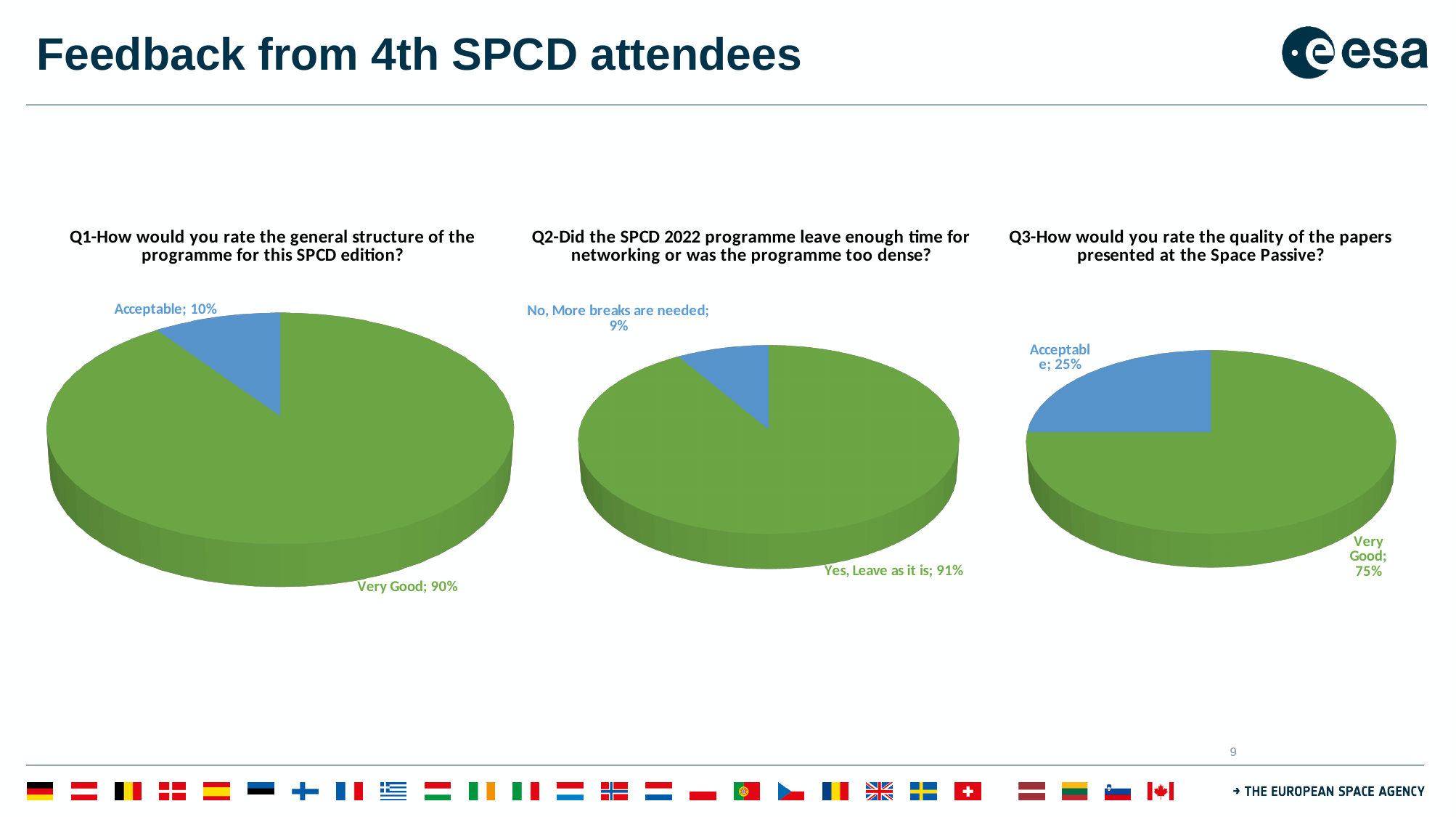
In the Q3 chart (right), what share of respondents rated the quality of the papers as Acceptable? 25% Which is larger: the Acceptable share in the Q1 chart (left) or the Acceptable share in the Q3 chart (right)? Q3 chart (right) In the Q1 chart (left), what share of respondents rated the programme structure as Very Good? 90% In the Q1 chart (left), what share of respondents rated the programme structure as Acceptable? 10% In the Q3 chart (right), what is the difference in percentage points between the Very Good and Acceptable shares? 50 In the Q2 chart (middle), what share of respondents answered 'No, More breaks are needed'? 9% What type of chart is used for the Q1 chart (left)? Pie chart How many charts are shown on the slide? 3 How many slices does the Q2 chart (middle) have? 2 In the Q2 chart (middle), what share of respondents answered 'Yes, Leave as it is'? 91% In the Q1 chart (left), which category has the smallest share? Acceptable In the Q3 chart (right), which category has the largest share? Very Good